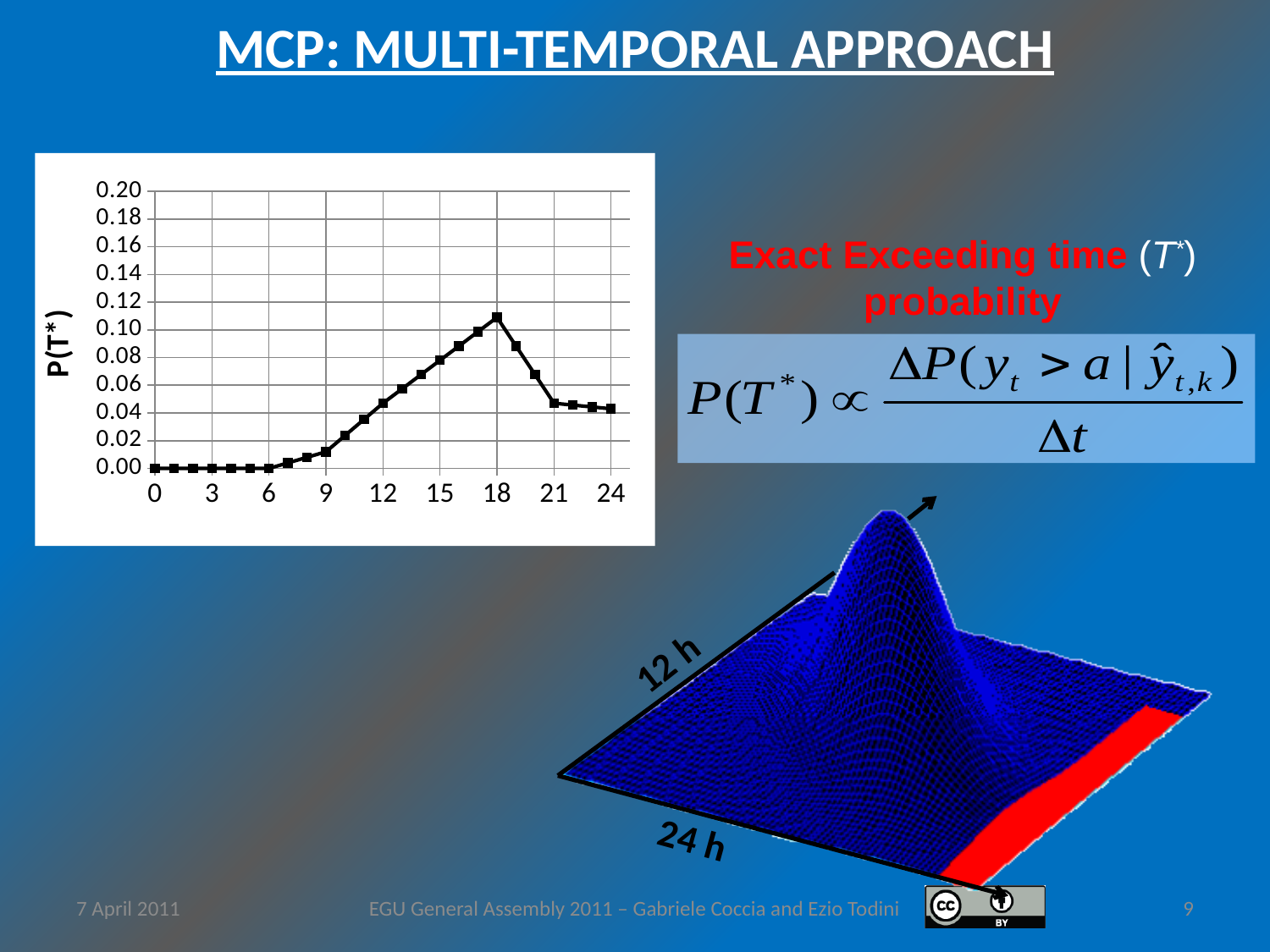
Is the value of P(T*) at x = 18 greater or less than 0.10? greater At which x-axis value does P(T*) reach its highest point? 18 What kind of chart is shown on the slide? line chart Do the P(T*) values rise or fall between x = 9 and x = 18? rise Which has the larger P(T*) value, x = 12 or x = 15? 15 Do the P(T*) values rise or fall between x = 18 and x = 21? fall What is the value of P(T*) at x = 3? 0.00 Is the value of P(T*) at x = 15 greater or less than 0.06? greater Is the value of P(T*) at x = 9 greater or less than 0.02? less What is the label on the y axis of the chart? P(T*)